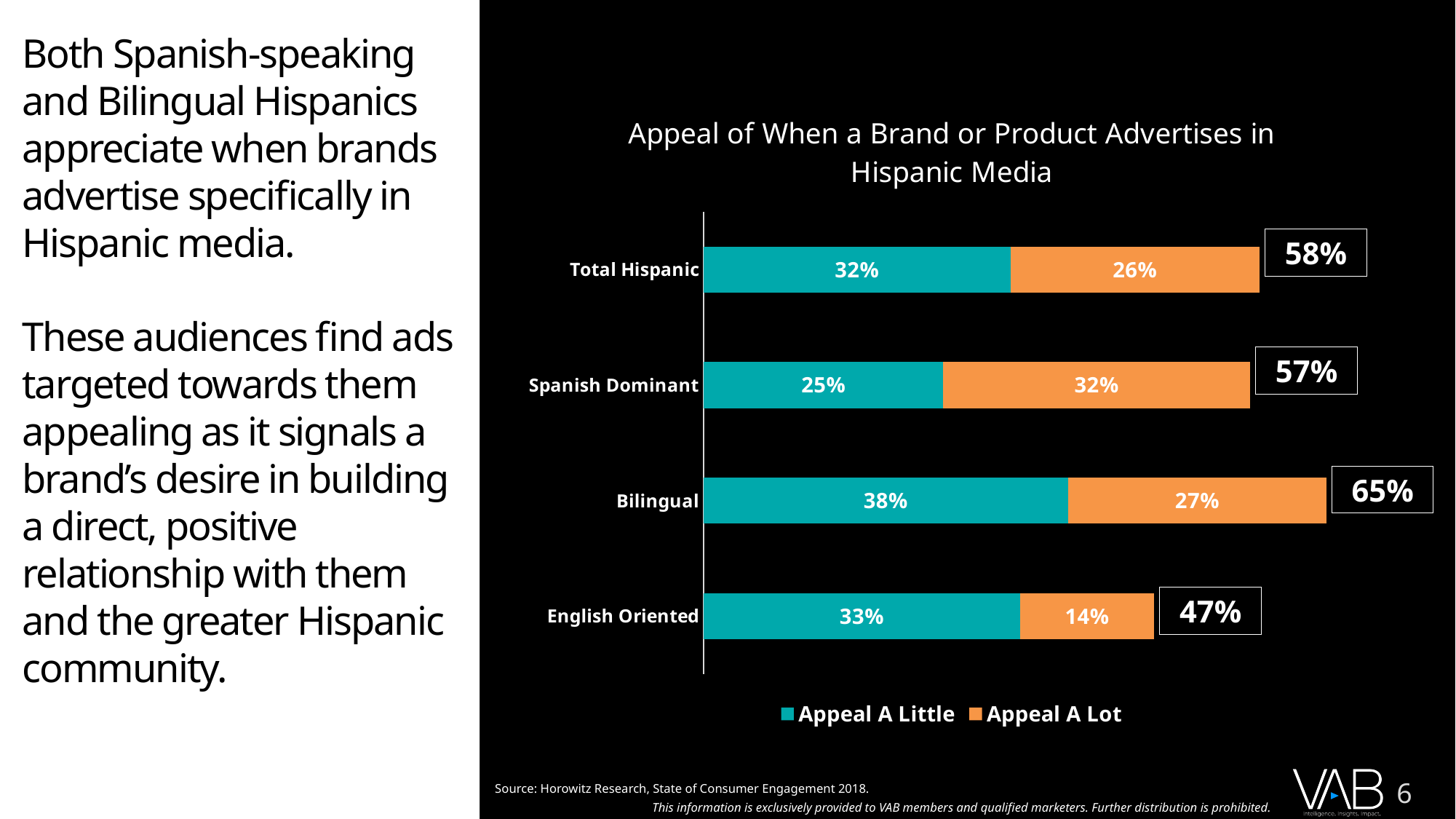
Which category has the lowest 'Appeal A Lot' value? English Oriented What colour represents 'Appeal A Lot' in the chart? Orange What is the 'Appeal A Little' value for Bilingual? 38% What kind of chart is shown? Stacked bar chart What is the total appeal shown for Total Hispanic? 58% What is the difference between the 'Appeal A Little' values for Bilingual and Spanish Dominant? 13% How many categories are shown on the chart? 4 Which is larger for Spanish Dominant: 'Appeal A Little' or 'Appeal A Lot'? Appeal A Lot What is the 'Appeal A Lot' value for English Oriented? 14% How many series does the legend list? 2 Which category has the highest total appeal? Bilingual What is the 'Appeal A Lot' value for Spanish Dominant? 32%